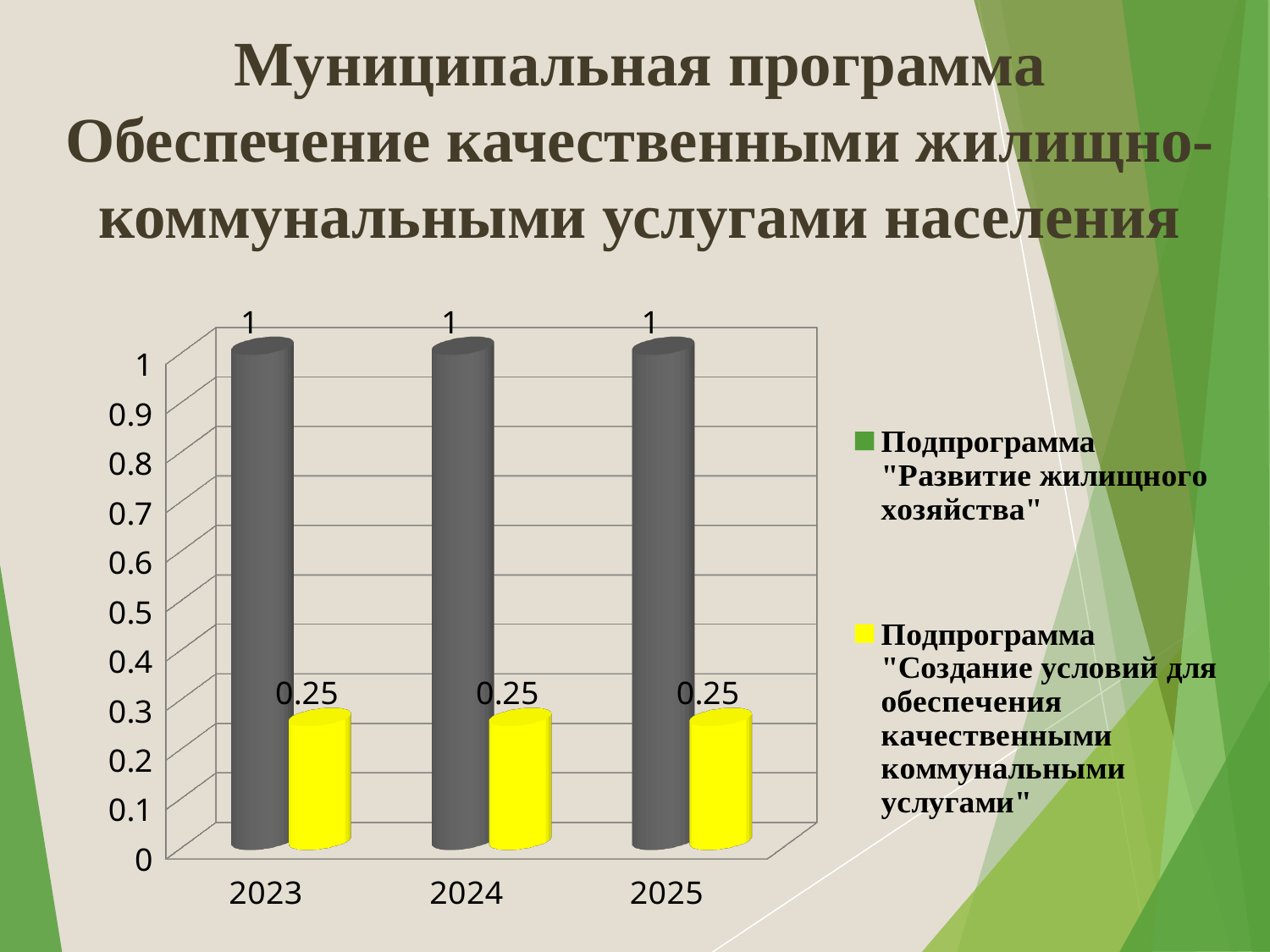
Do the values for Подпрограмма "Развитие жилищного хозяйства" rise, fall or stay the same from 2023 to 2025? Stay the same Is the value for Подпрограмма "Создание условий для обеспечения качественными коммунальными услугами" in 2023 greater or less than 0.5? less What kind of chart is shown on the slide? Bar chart How many years are shown on the x axis? 3 What is the value for Подпрограмма "Создание условий для обеспечения качественными коммунальными услугами" in 2025? 0.25 What is the difference between the two subprogramme values in 2023? 0.75 What is the value for Подпрограмма "Развитие жилищного хозяйства" in 2023? 1 What colour are the bars for Подпрограмма "Создание условий для обеспечения качественными коммунальными услугами"? Yellow What is the value for Подпрограмма "Создание условий для обеспечения качественными коммунальными услугами" in 2024? 0.25 How many series does the legend list? 2 What is the value for Подпрограмма "Развитие жилищного хозяйства" in 2025? 1 Which subprogramme has the larger value in 2024? Подпрограмма "Развитие жилищного хозяйства"